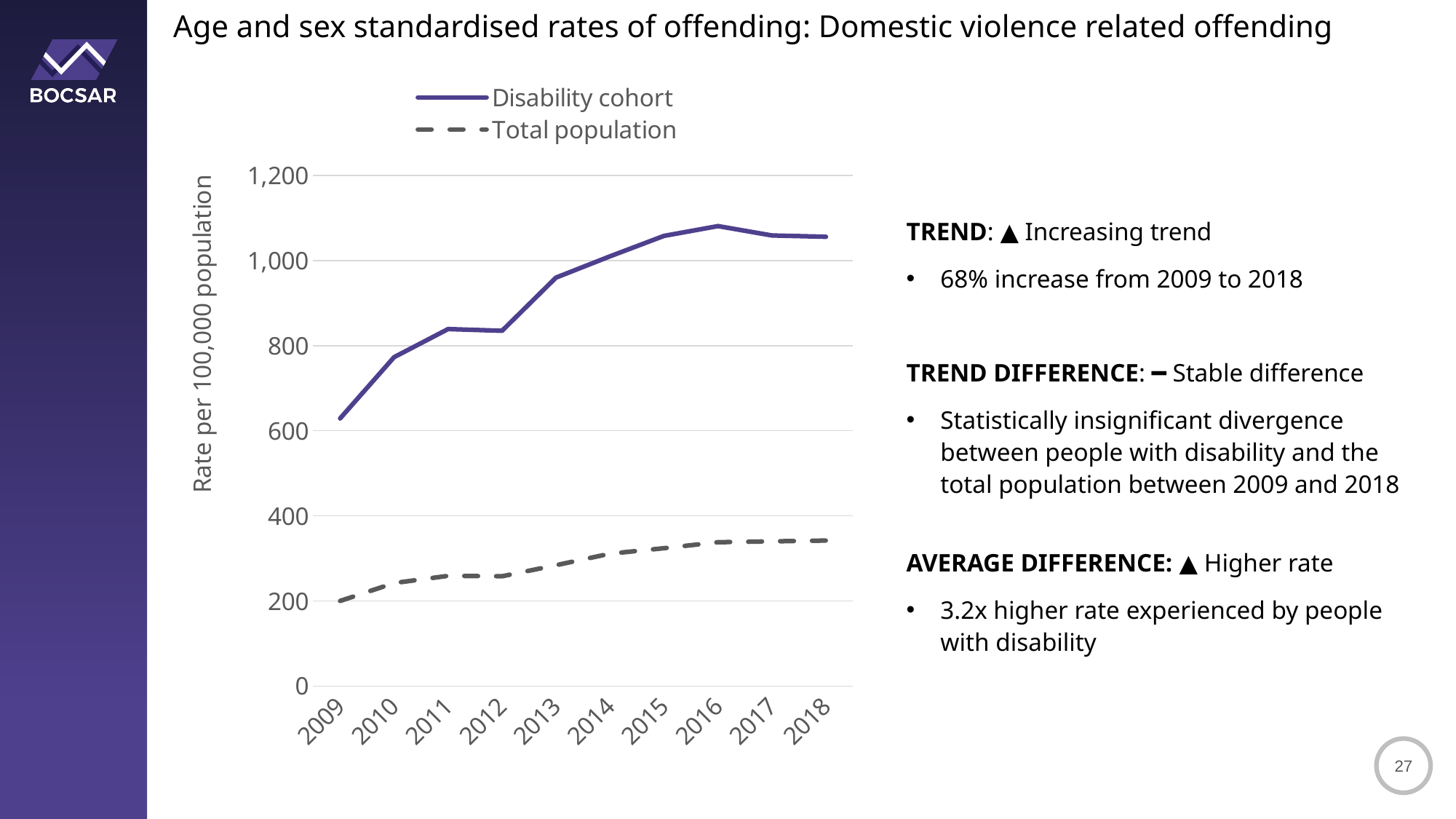
In which year is the Disability cohort rate lowest? 2009 Is the value for the Total population in 2009 greater or less than 400? less Is the value for the Disability cohort in 2009 greater or less than 800? less How many years are plotted along the x axis? 10 Which series is drawn with a dashed line? Total population Which series has the higher rate in 2018, Disability cohort or Total population? Disability cohort Does the Total population rate generally rise or fall from 2009 to 2018? Rise Is the value for the Total population in 2018 greater or less than 400? less What kind of chart is shown on the slide? Line chart How many series does the legend list? 2 What is the label on the y axis? Rate per 100,000 population